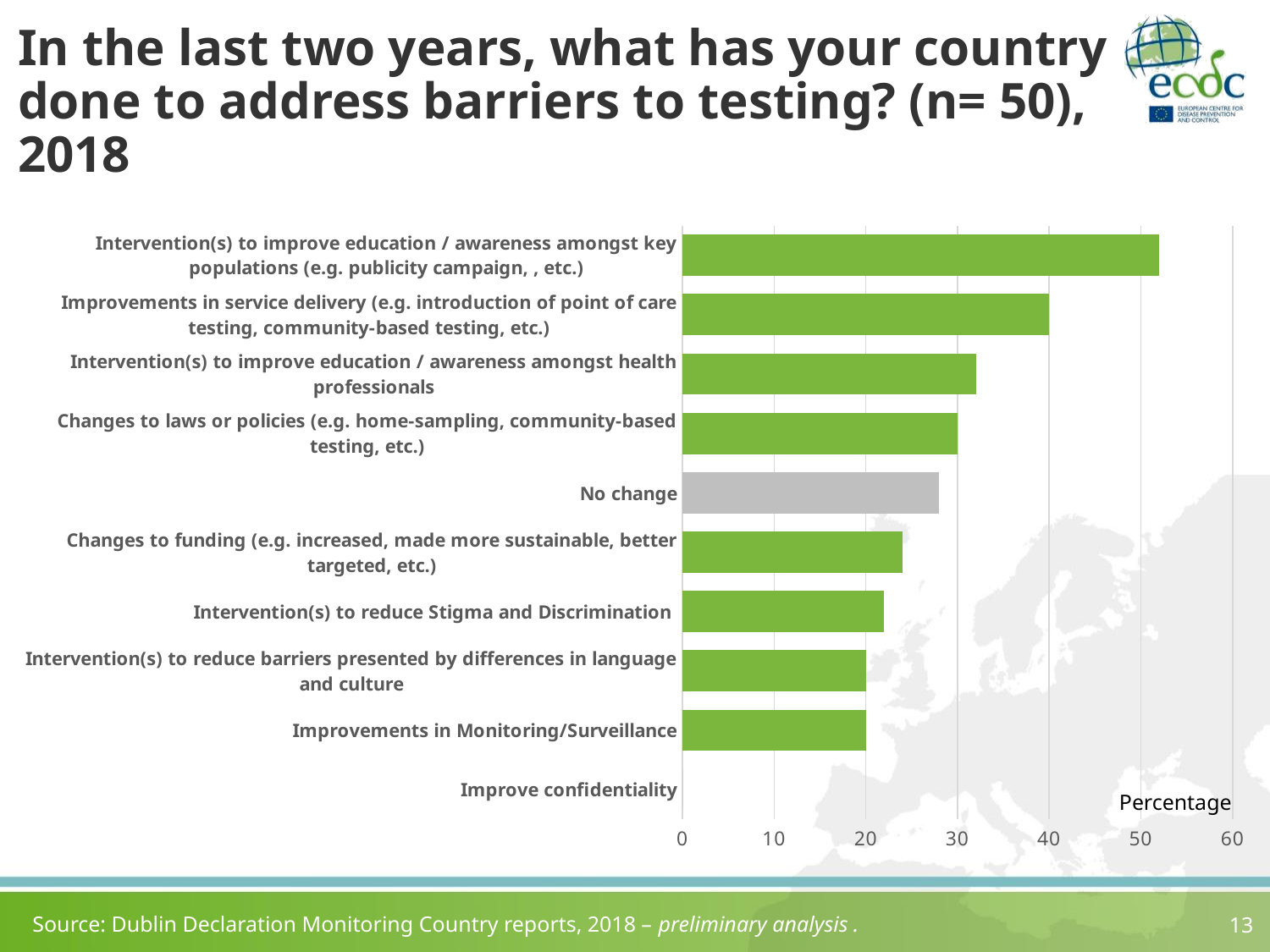
How many categories are plotted in the chart? 10 What kind of chart is shown on the slide? Bar chart Is the value for 'Intervention(s) to reduce Stigma and Discrimination' greater or less than 30? less Which is larger: the value for 'Improvements in service delivery' or the value for 'Changes to laws or policies'? Improvements in service delivery Is the value for 'Intervention(s) to improve education / awareness amongst health professionals' greater or less than 30? greater Which category's bar is coloured grey instead of green? No change What is the label on the horizontal axis of the chart? Percentage Which category has the lowest value? Improve confidentiality Is the value for 'No change' greater or less than 30? less Which category has the highest value? Intervention(s) to improve education / awareness amongst key populations (e.g. publicity campaign, , etc.)